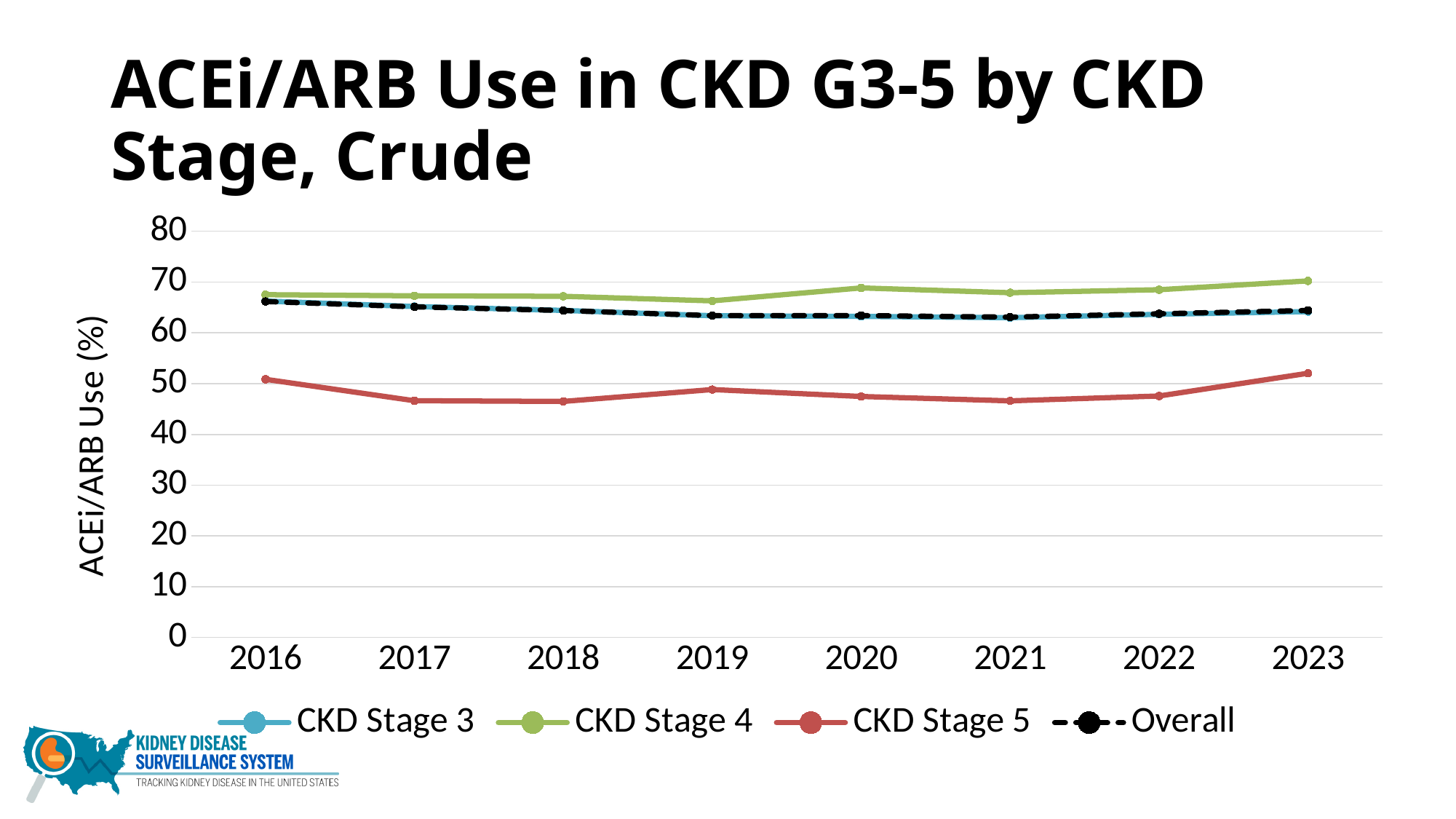
What is the label of the y axis? ACEi/ARB Use (%) Is the value for CKD Stage 5 in 2016 greater or less than 60? less How many years are shown on the x axis? 8 In 2019, which is larger: the value for CKD Stage 4 or the value for CKD Stage 5? CKD Stage 4 What kind of chart is shown on the slide? line chart How many series does the legend list? 4 Which series has the highest value in 2023? CKD Stage 4 Is the value for CKD Stage 4 in 2023 greater or less than 60? greater Is the value for CKD Stage 5 in 2017 greater or less than 50? less Which series is drawn with a dashed line? Overall Does the CKD Stage 5 line rise or fall from 2021 to 2023? rise Which series has the lowest value in 2020? CKD Stage 5